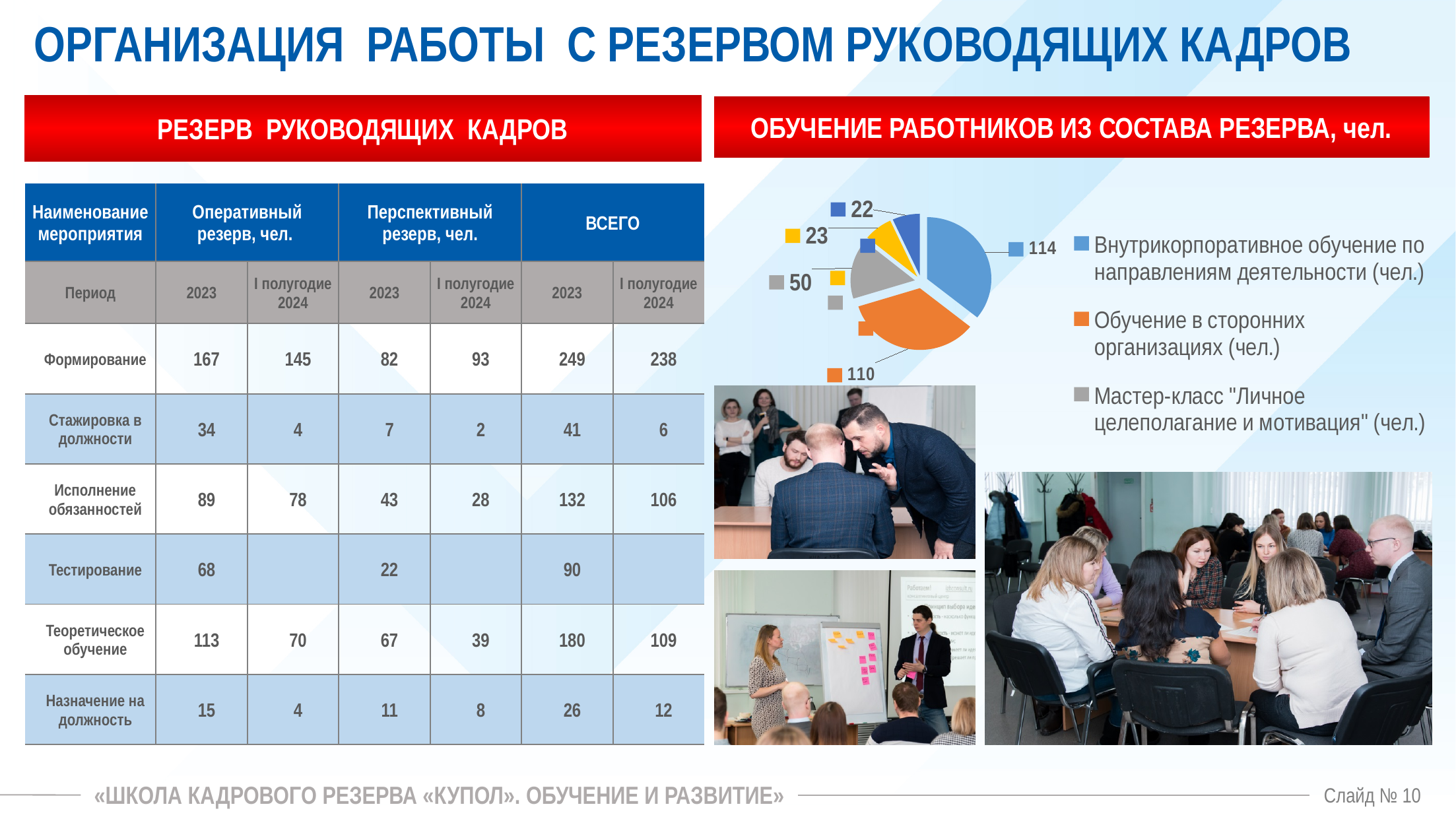
In the pie chart, which is larger: "Внутрикорпоративное обучение" or "Обучение в сторонних организациях"? Внутрикорпоративное обучение What type of chart is shown under the heading "ОБУЧЕНИЕ РАБОТНИКОВ ИЗ СОСТАВА РЕЗЕРВА, чел."? Pie chart What is the difference between the values for "Внутрикорпоративное обучение" and "Обучение в сторонних организациях" in the pie chart? 4 In the pie chart, what is the value for "Мастер-класс "Личное целеполагание и мотивация" (чел.)"? 50 In the pie chart, what is the value for "Внутрикорпоративное обучение по направлениям деятельности (чел.)"? 114 How much larger is the value for "Внутрикорпоративное обучение" than the value for "Мастер-класс" in the pie chart? 64 Which legend category has the largest slice in the pie chart? Внутрикорпоративное обучение по направлениям деятельности (чел.) What is the smallest data label shown on the pie chart? 22 What colour represents "Обучение в сторонних организациях (чел.)" in the pie chart? Orange How many slices does the pie chart have? 5 In the pie chart, what is the value for "Обучение в сторонних организациях (чел.)"? 110 How many entries does the legend of the pie chart list? 3